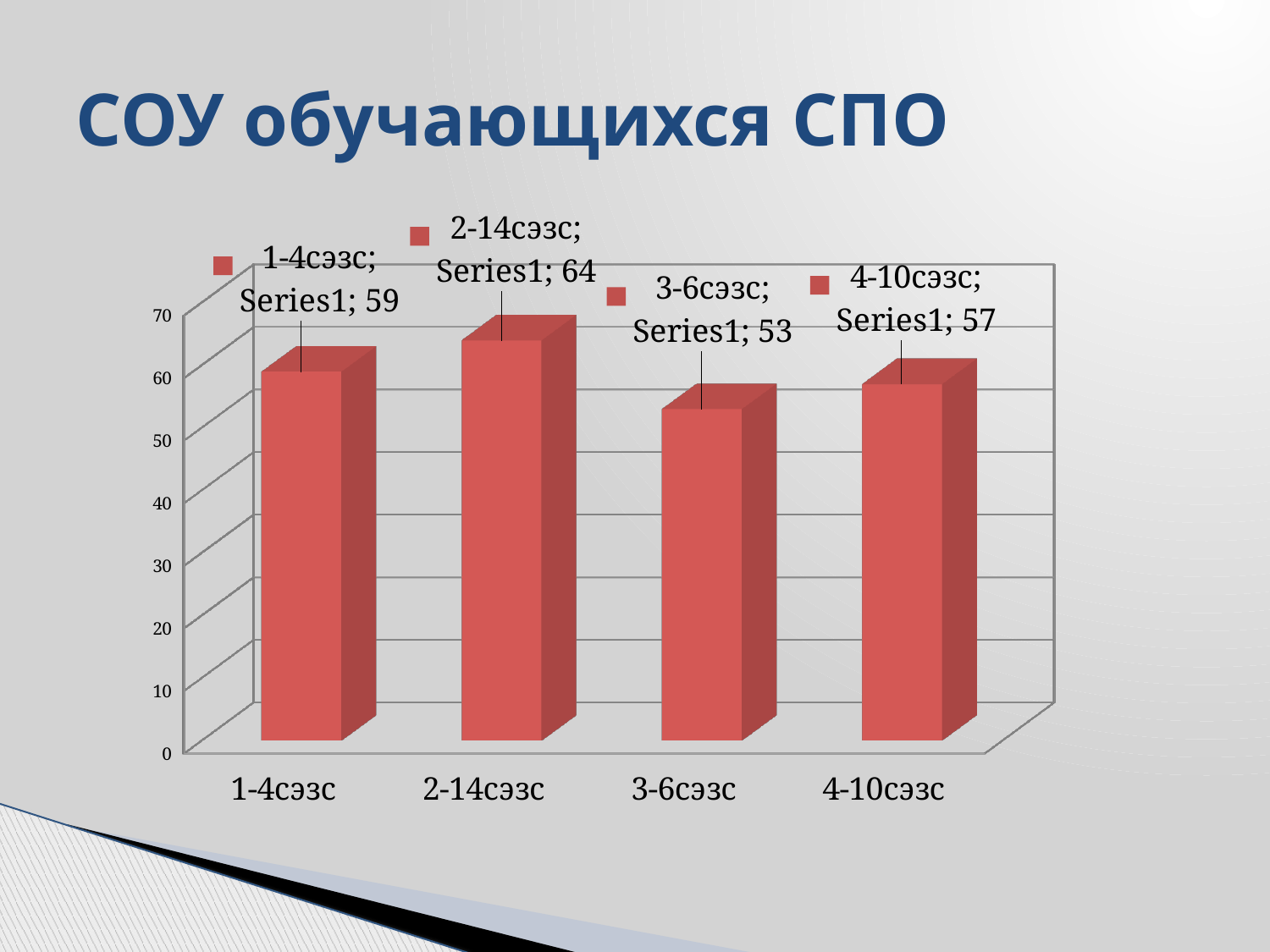
Which category has the highest value? 2-14сэзс What kind of chart is shown on the slide? bar chart Which is larger, the value for 1-4сэзс or the value for 4-10сэзс? 1-4сэзс What is the value for 3-6сэзс? 53 Is the value for 3-6сэзс greater or less than 60? less Which category has the lowest value? 3-6сэзс What is the value for 1-4сэзс? 59 What is the title of the slide? СОУ обучающихся СПО What is the value for 4-10сэзс? 57 How many categories are shown on the chart? 4 What is the difference between the values for 2-14сэзс and 3-6сэзс? 11 What is the value for 2-14сэзс? 64